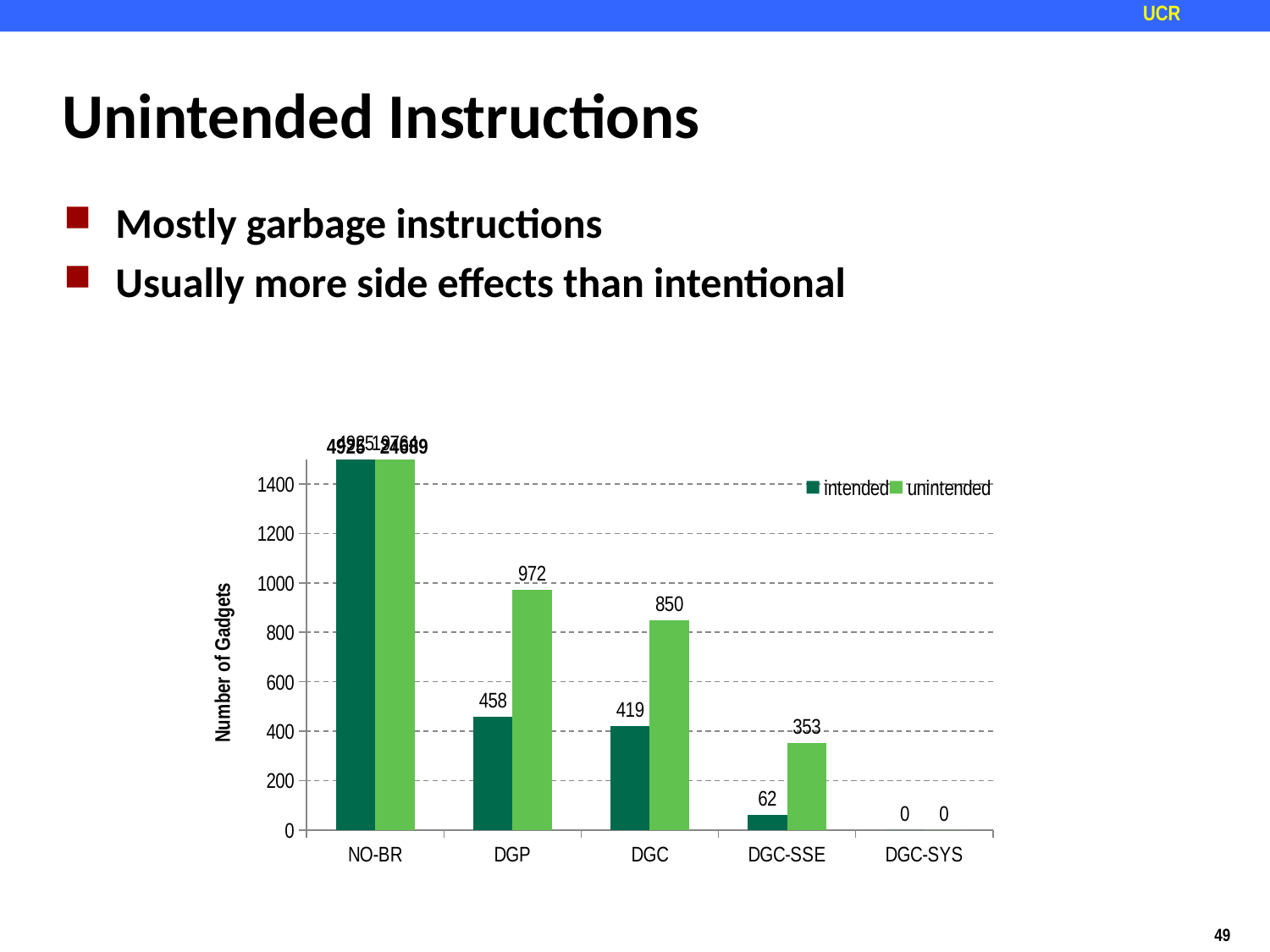
Which is larger for DGC-SSE, the intended or the unintended value? unintended What is the difference between the unintended and intended values for DGC? 431 What is the intended value for DGC-SSE? 62 How many series does the legend list? 2 What is the unintended value for DGC-SYS? 0 What type of chart is shown on the slide? bar chart What is the unintended value for DGP? 972 How many categories are shown on the x axis? 5 What is the label of the y axis? Number of Gadgets Is the intended value for NO-BR greater or less than 1400? greater What is the intended value for DGC? 419 Which category has the lowest unintended value? DGC-SYS